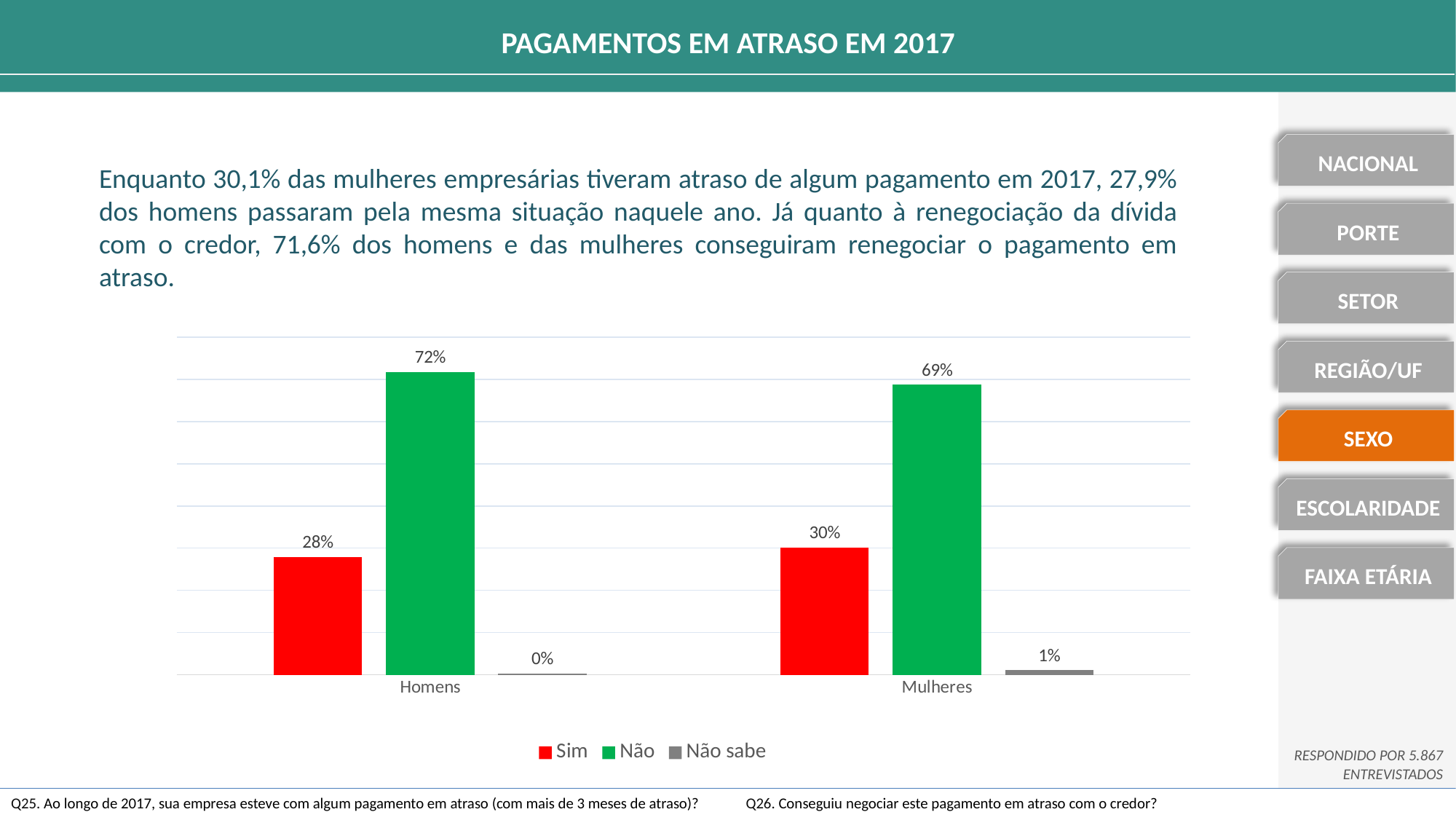
What is the value for "Não sabe" for Mulheres? 1% What is the value for "Não" for Homens? 72% What is the difference between the "Não" values for Homens and Mulheres? 3% What is the value for "Sim" for Homens? 28% What kind of chart is shown on the slide? Bar chart Which is larger: the "Sim" value for Homens or for Mulheres? Mulheres How many categories are shown on the x axis? 2 Which series has the lowest value for Mulheres? Não sabe How many series does the legend list? 3 What is the value for "Não" for Mulheres? 69% Which series has the highest value for Homens? Não What colour represents the "Sim" series? Red